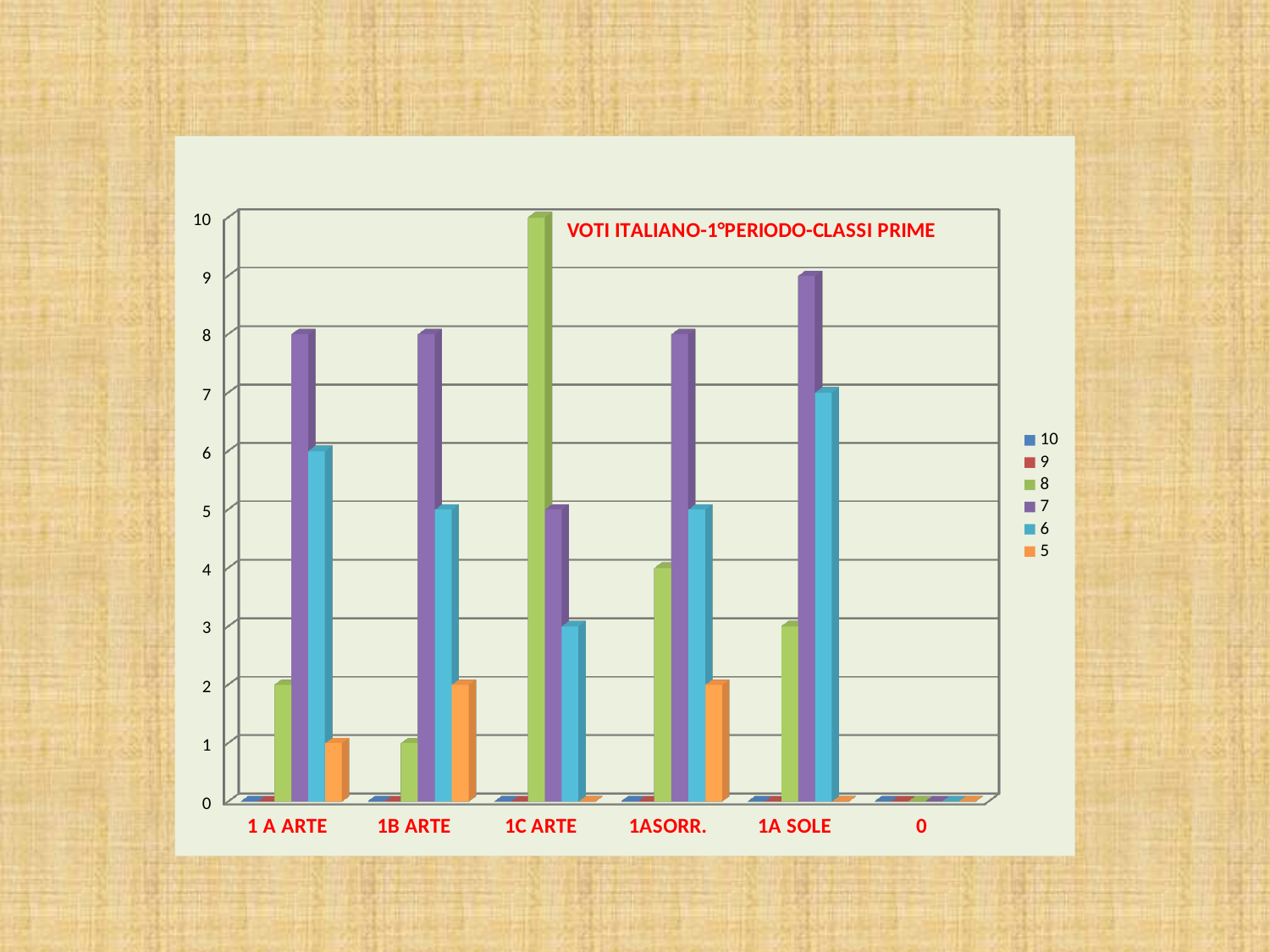
What is the difference between series 7 and series 6 for 1B ARTE? 3 How many categories are shown on the x axis? 6 Is the value of series 7 for 1C ARTE greater or less than 8? less What is the value of series 6 for 1 A ARTE? 6 Which category has the highest value for series 7? 1A SOLE Which is larger for 1ASORR.: series 8 or series 6? series 6 What is the value of series 8 for 1C ARTE? 10 How many series does the legend list? 6 Which category has the highest value for series 8? 1C ARTE What is the title of the chart? VOTI ITALIANO-1°PERIODO-CLASSI PRIME What is the value of series 7 for 1A SOLE? 9 What kind of chart is shown on the slide? bar chart